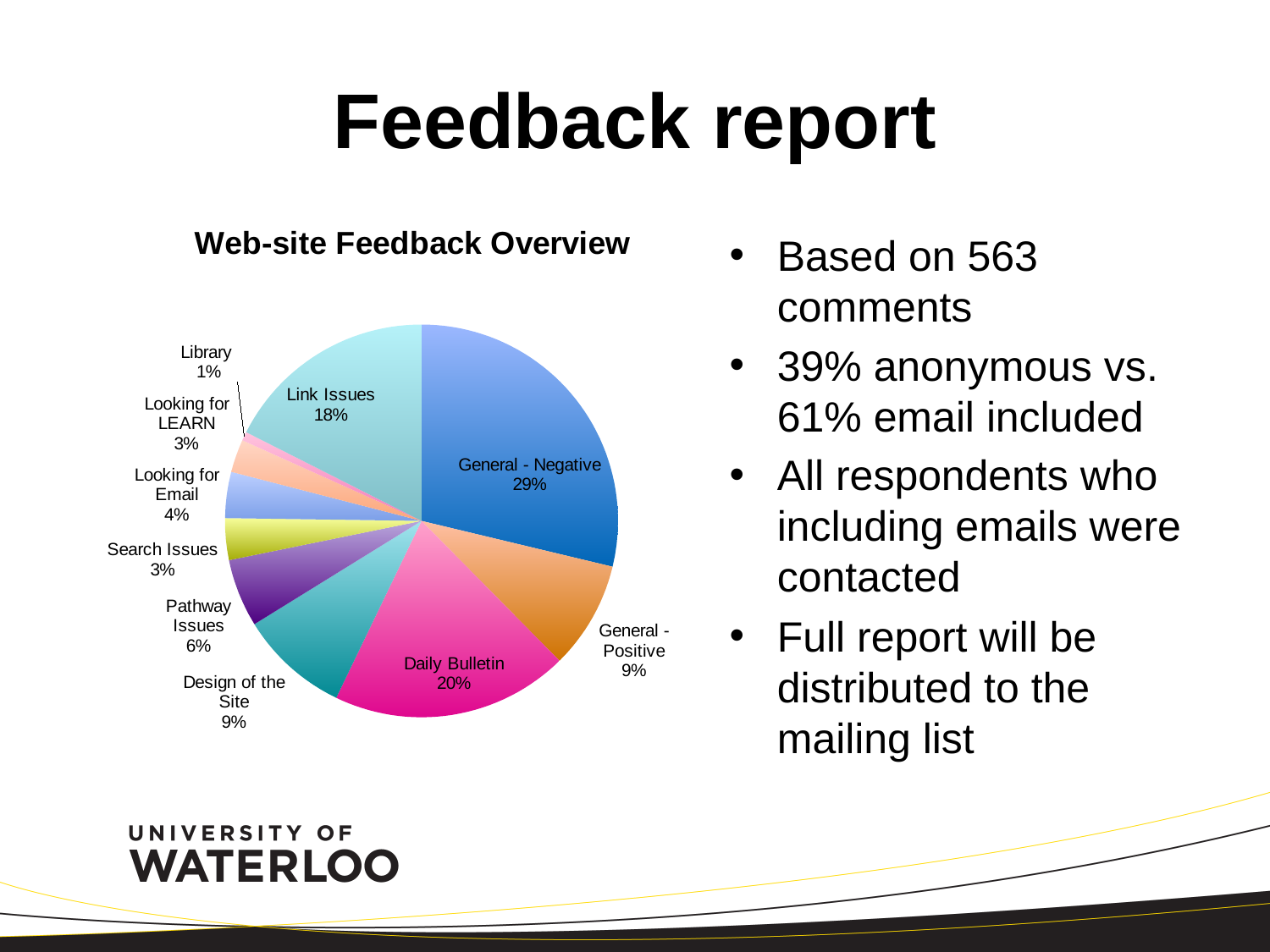
Which category has the smallest slice of the pie? Library What is the difference in percentage points between General - Negative and Daily Bulletin? 9 What share of the pie is Daily Bulletin? 20% What share of the pie is General - Negative? 29% What share of the pie is Looking for Email? 4% What type of chart is shown on the slide? pie chart What is the title of the chart? Web-site Feedback Overview Which is larger, the share for Link Issues or the share for General - Positive? Link Issues How many categories are shown in the pie chart? 10 Which category has the largest slice of the pie? General - Negative